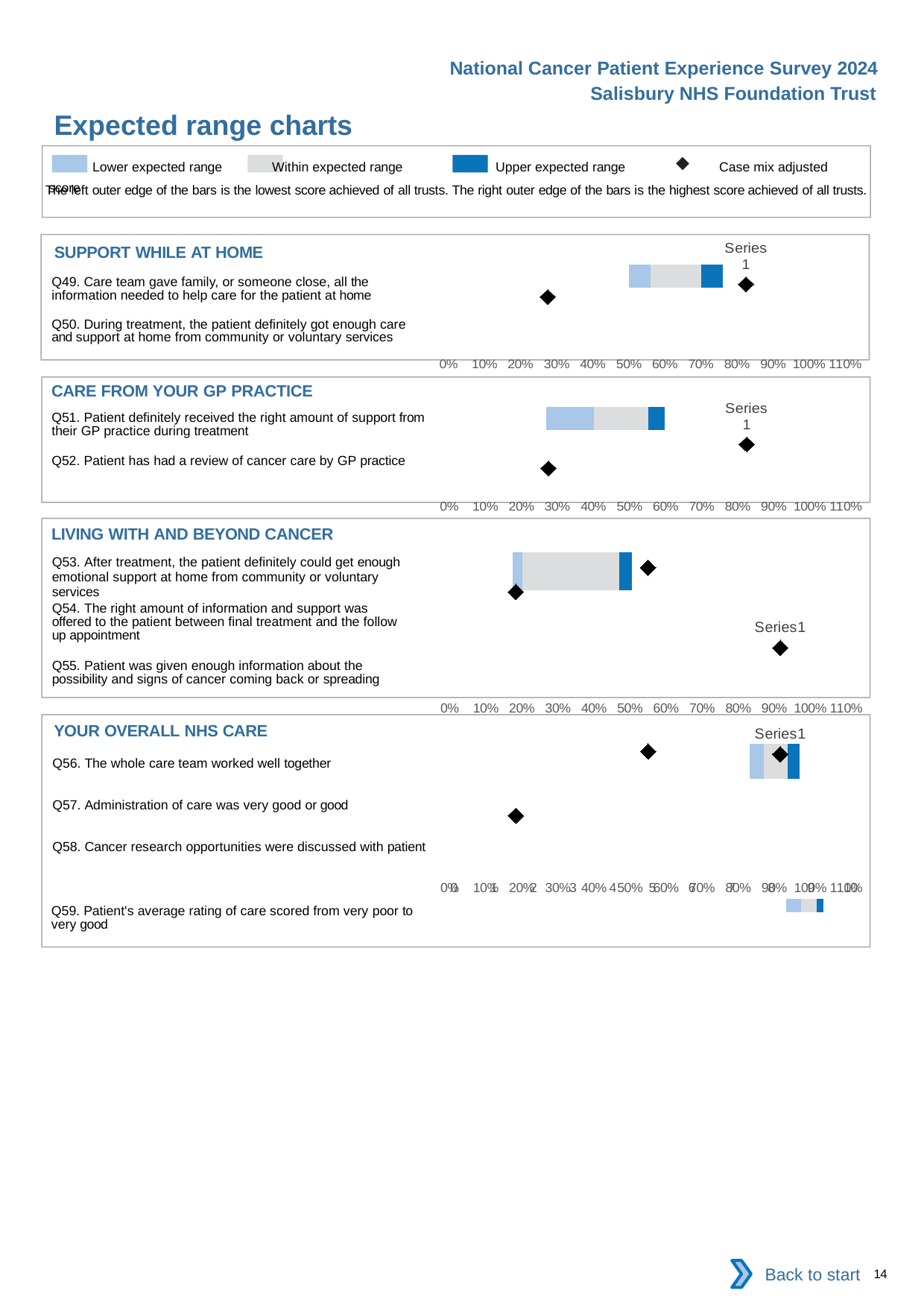
In the LIVING WITH AND BEYOND CANCER chart, is the case mix adjusted score diamond labelled 'Series1' greater or less than 80%? greater What kind of chart is used in the expected range charts on this slide? bar chart How many survey questions are listed in the CARE FROM YOUR GP PRACTICE section? 2 In the SUPPORT WHILE AT HOME chart, is the case mix adjusted score diamond labelled 'Series 1' greater or less than 70%? greater In the SUPPORT WHILE AT HOME chart, is the left edge of the expected range bar greater or less than 40%? greater How many survey questions are listed in the LIVING WITH AND BEYOND CANCER section? 3 How many survey questions are listed in the YOUR OVERALL NHS CARE section? 4 How many entries does the legend at the top of the slide list? 4 According to the legend, what symbol marks the case mix adjusted score? diamond